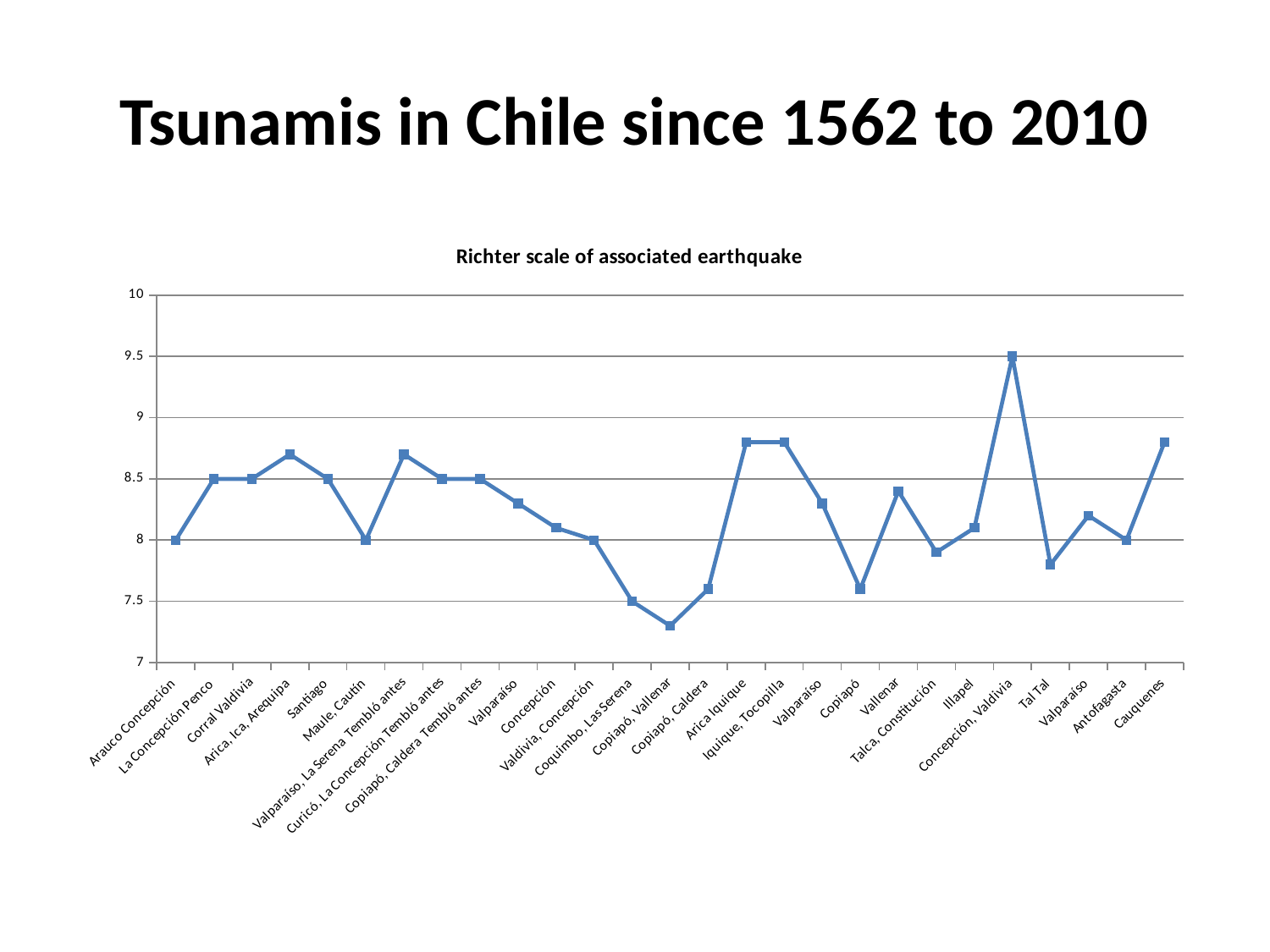
How many data points are plotted on the chart? 27 What is the Richter scale value for Concepción, Valdivia? 9.5 Which category has the highest Richter scale value? Concepción, Valdivia What is the Richter scale value for Coquimbo, Las Serena? 7.5 What is the title of the chart? Richter scale of associated earthquake Which category has the lowest Richter scale value? Copiapó, Vallenar What is the Richter scale value for Santiago? 8.5 Is the value for Copiapó greater or less than 8? less What type of chart is shown on the slide? line chart What is the difference between the values for Concepción, Valdivia and Coquimbo, Las Serena? 2 Is the value for Arica, Iquique greater or less than 8.5? greater Which has a higher Richter scale value, Arica, Iquique or Tal Tal? Arica, Iquique